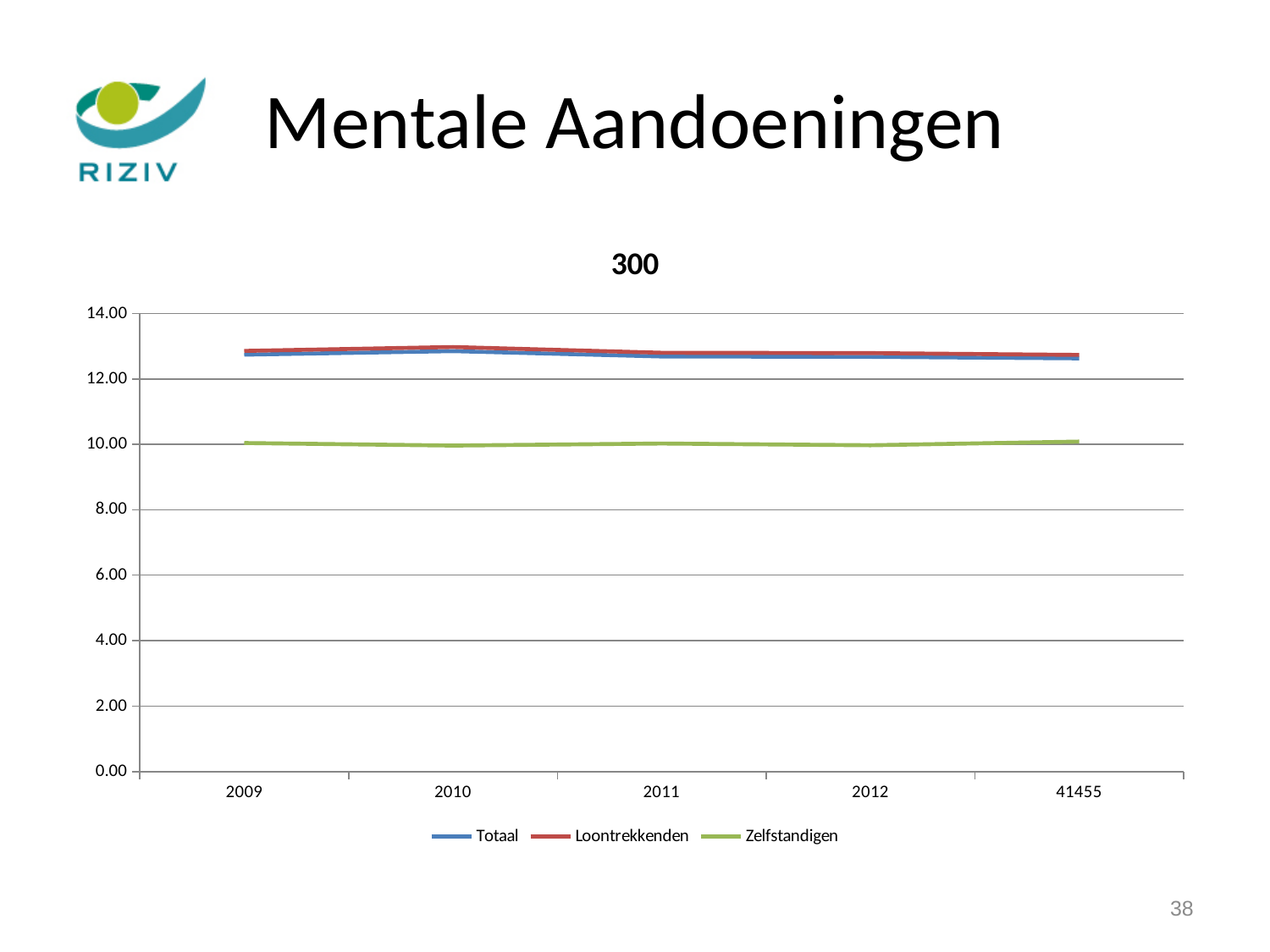
Is the value for Totaal in 2012 greater or less than 14.00? less Is the value for Zelfstandigen in 2009 greater or less than 12.00? less Is the value for Loontrekkenden in 2010 greater or less than 12.00? greater What kind of chart is shown on the slide? line chart In 2012, which is larger: the value for Loontrekkenden or the value for Zelfstandigen? Loontrekkenden Which series has the lowest values across all years? Zelfstandigen How many series does the legend list? 3 How many points along the x axis does the chart have? 5 What is the title of the chart? 300 Which series are listed in the legend? Totaal, Loontrekkenden, Zelfstandigen